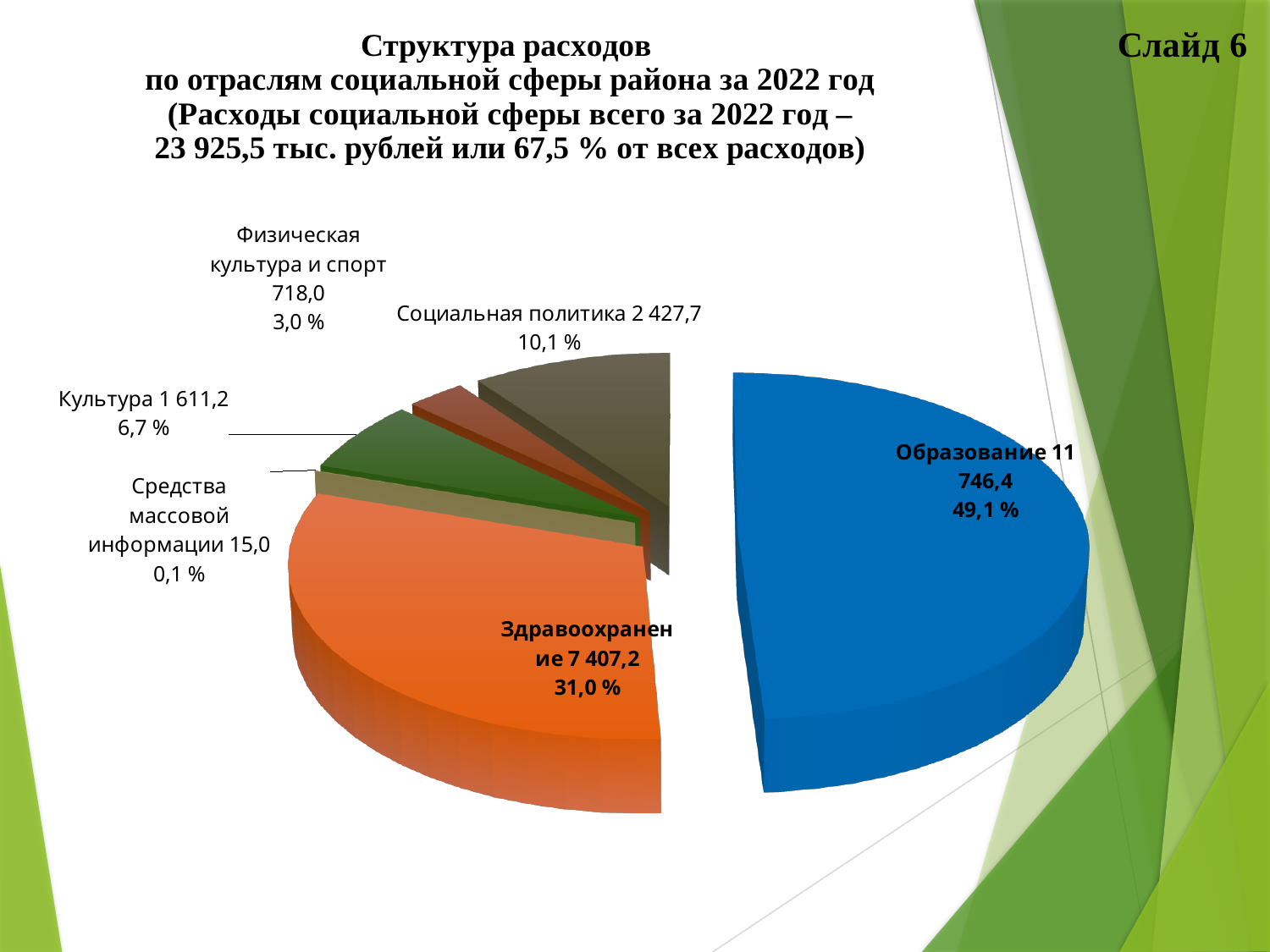
What share of the pie does Здравоохранение account for? 31,0 % How many categories (slices) does the pie chart show? 6 Which category has the smallest share of the pie? Средства массовой информации What colour is the slice for Образование? Blue What is the difference in percentage points between the shares of Образование and Здравоохранение? 18,1 % What is the value shown for Физическая культура и спорт? 718,0 Which is larger, the value for Здравоохранение or the value for Социальная политика? Здравоохранение Which category has the largest share of the pie? Образование What percentage is shown for Культура? 6,7 % What kind of chart is shown on the slide? Pie chart What is the value shown for Образование? 11 746,4 What is the value shown for Социальная политика? 2 427,7